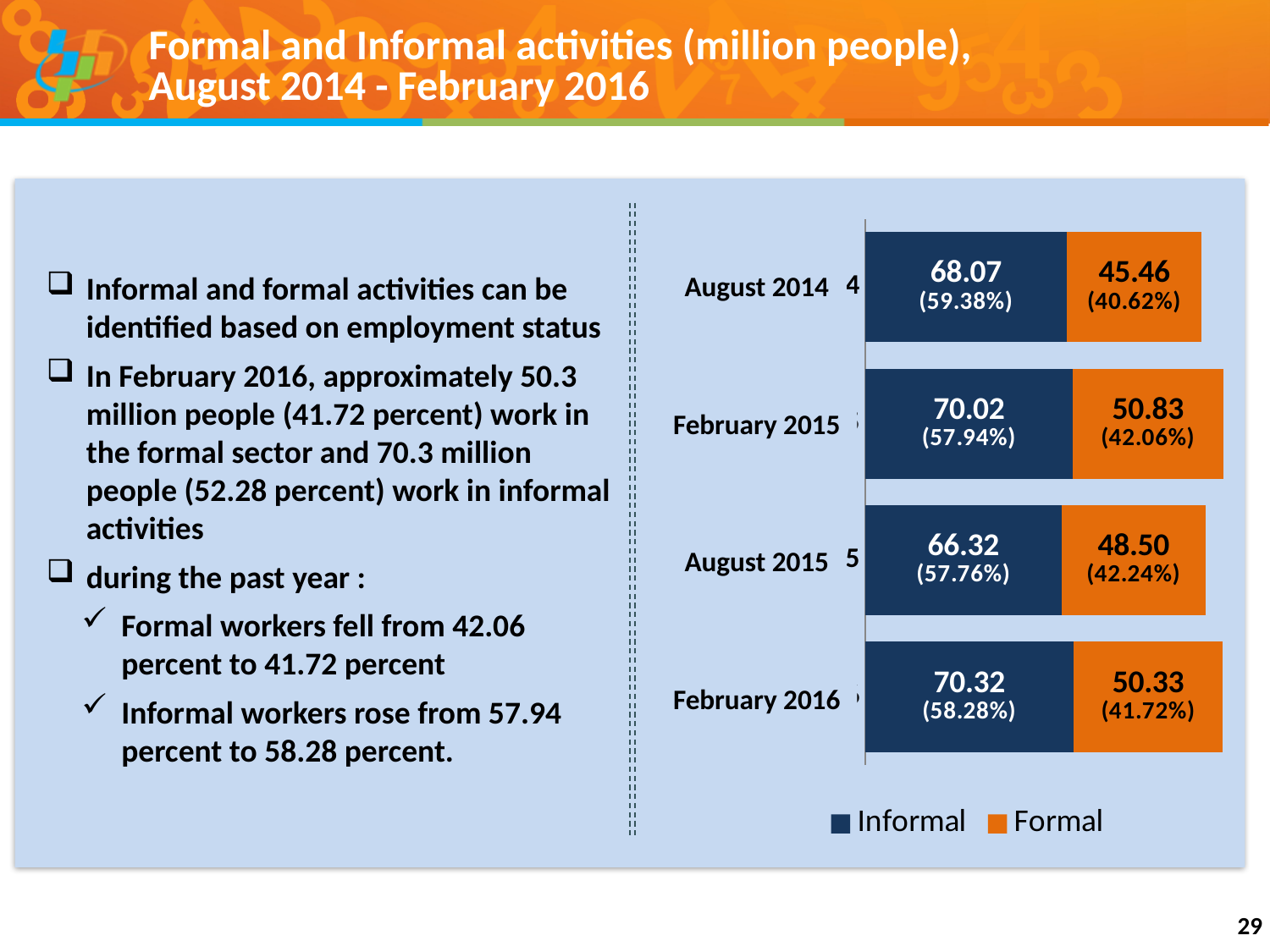
Which period has the lowest Informal value? August 2015 How many series does the legend list? 2 Is the Formal value for August 2015 larger or smaller than the Formal value for February 2015? smaller What is the Informal value for August 2015? 66.32 What is the difference between the Informal and Formal values in August 2014? 22.61 What is the Informal value for August 2014? 68.07 Which period has the highest Formal value? February 2015 Which period has the lowest Formal value? August 2014 What is the total of the stacked bar for February 2016? 120.65 What percentage share is shown for Formal in February 2015? 42.06% How many periods are shown on the chart? 4 What is the Formal value for February 2016? 50.33